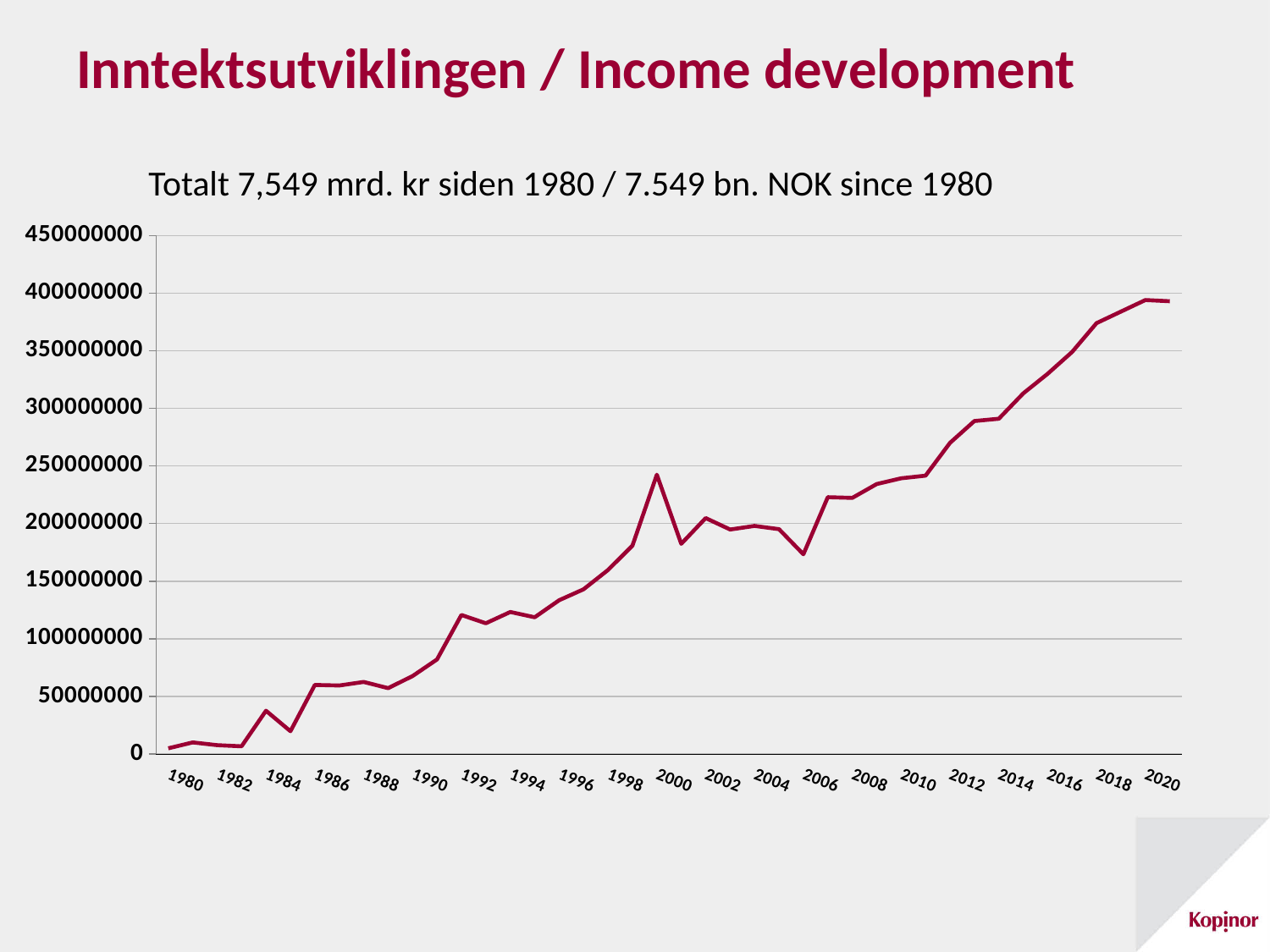
What is the title of the chart slide? Inntektsutviklingen / Income development Is the value for 2012 greater or less than 250000000? greater Overall, do the values rise or fall from 1980 to 2020? rise Which year has the larger value, 2005 or 2006? 2005 Is the value for 1999 greater or less than 200000000? less What total amount since 1980 is stated above the chart? 7,549 mrd. kr / 7.549 bn. NOK Which year has the lowest value on the chart? 1980 What kind of chart is shown on the slide? line chart Is the value for 2005 greater or less than 200000000? less Which year has the larger value, 1999 or 2000? 2000 How many year labels are shown on the x axis? 21